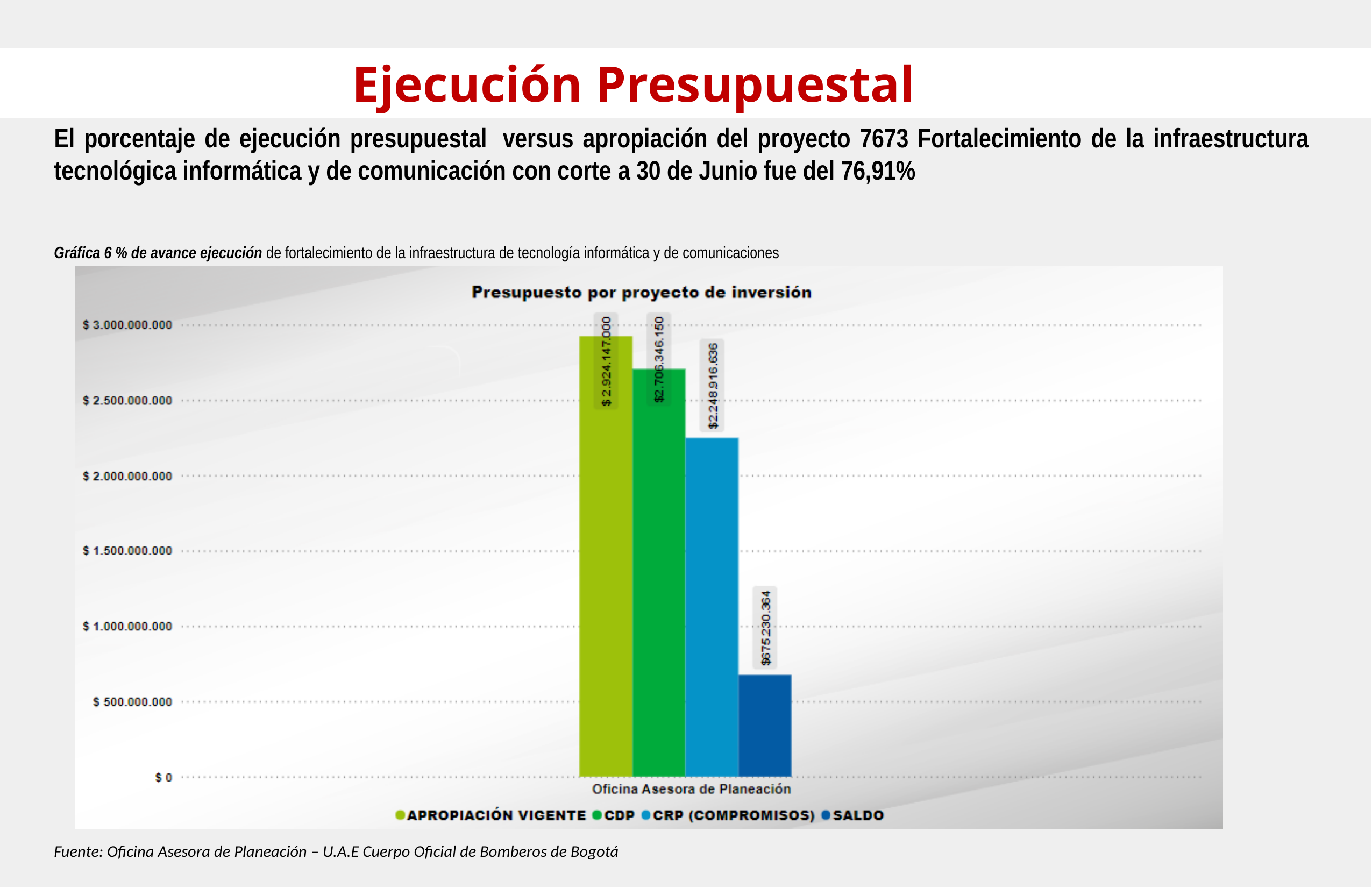
How many series does the chart legend list? 4 What type of chart is shown on the slide? bar chart What is the value of CDP? $2.706.346.150 What is the value of CRP (COMPROMISOS)? $2.248.916.636 What is the value of SALDO? $675.230.364 Which is larger, CDP or CRP (COMPROMISOS)? CDP What is the difference between APROPIACIÓN VIGENTE and CDP? $217.800.850 Which series has the lowest value? SALDO What is the value of APROPIACIÓN VIGENTE? $ 2.924.147.000 What is the title of the chart? Presupuesto por proyecto de inversión Which series has the highest value? APROPIACIÓN VIGENTE Is the value for SALDO greater or less than $ 1.000.000.000? less